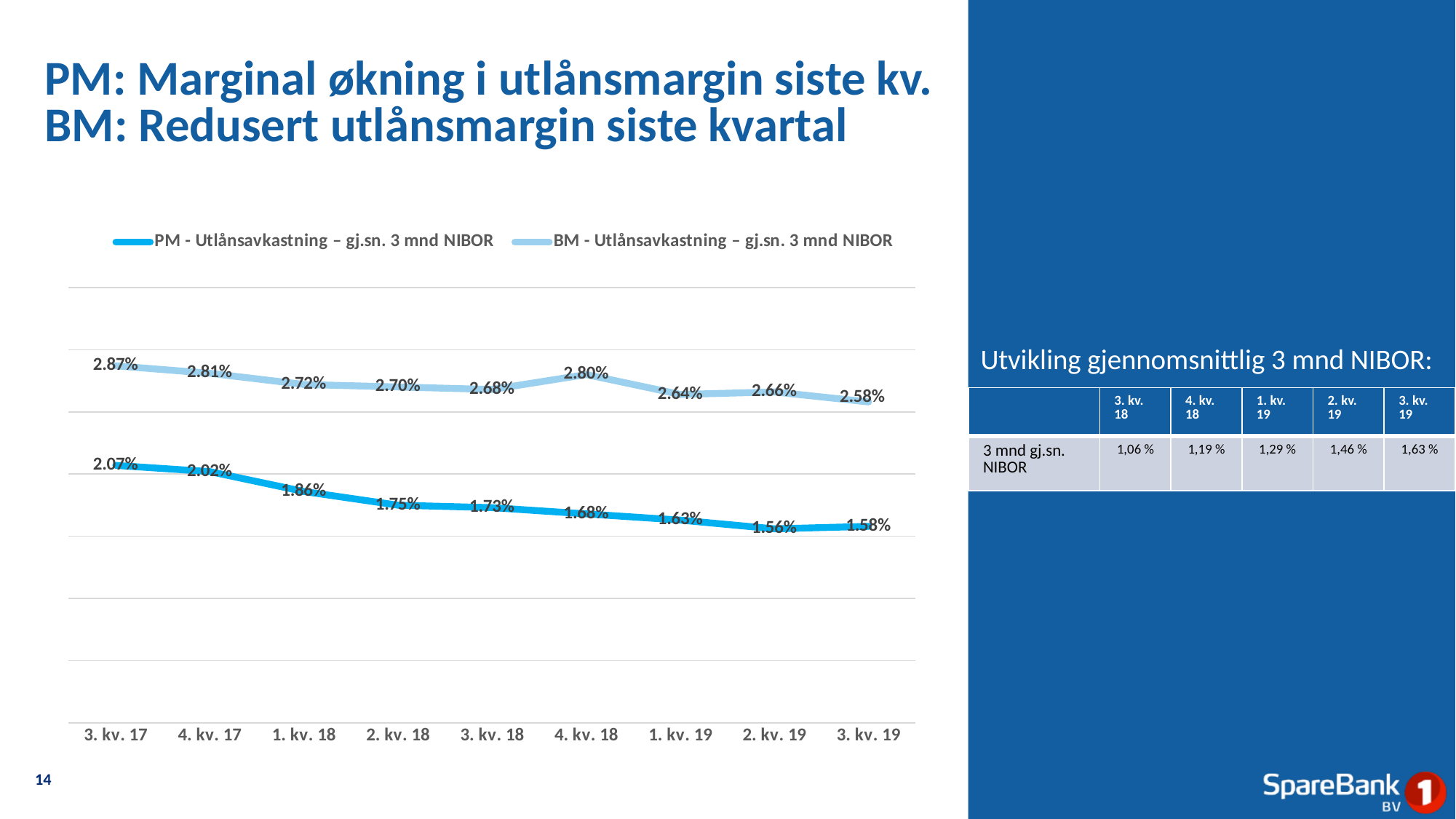
How many quarters are shown on the x axis of the chart? 9 In which quarter does the PM series reach its lowest value? 2. kv. 19 What kind of chart is shown on the slide? Line chart Which series has the higher value for 2. kv. 18, PM or BM? BM In which quarter does the BM series reach its highest value? 3. kv. 17 What is the value of the PM - Utlånsavkastning – gj.sn. 3 mnd NIBOR series for 3. kv. 19? 1.58% What is the value of the PM series for 1. kv. 18? 1.86% What is the value of the BM - Utlånsavkastning – gj.sn. 3 mnd NIBOR series for 4. kv. 18? 2.80% By how much did the PM series change from 3. kv. 17 to 3. kv. 19? 0.49% How many series does the chart legend list? 2 What is the difference between the BM value and the PM value for 3. kv. 19? 1.00% Does the PM series generally rise or fall from 3. kv. 17 to 2. kv. 19? Fall